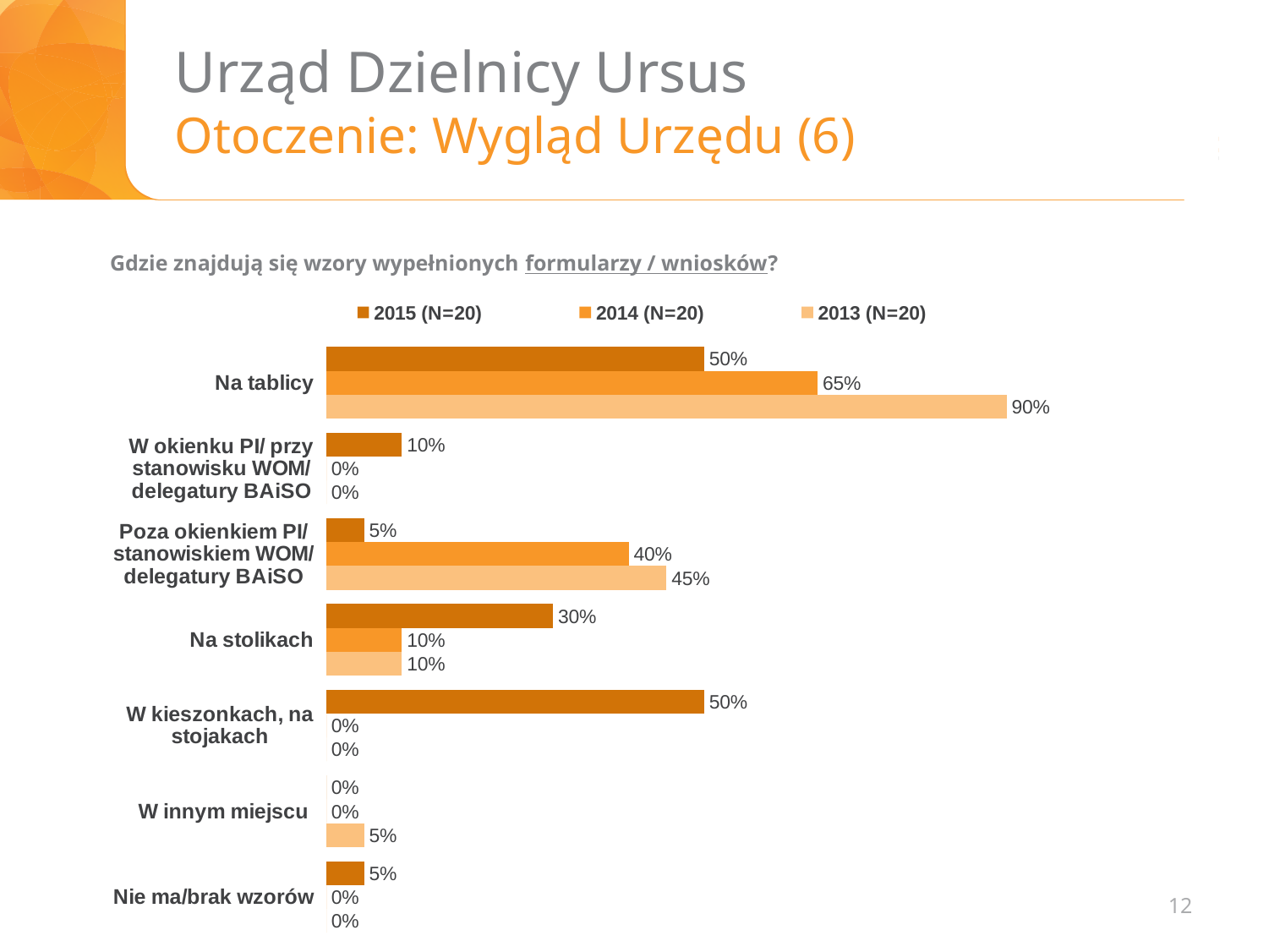
What is the value for 'W innym miejscu' in the 2013 (N=20) series? 5% What is the value for 'W kieszonkach, na stojakach' in the 2015 (N=20) series? 50% What is the value for 'Na stolikach' in the 2015 (N=20) series? 30% What kind of chart is shown on the slide? bar chart How many series does the legend list? 3 What question is the chart answering, as stated above it? Gdzie znajdują się wzory wypełnionych formularzy / wniosków? Which category has the highest value in the 2013 (N=20) series? Na tablicy What is the value for 'Poza okienkiem PI/ stanowiskiem WOM/ delegatury BAiSO' in the 2014 (N=20) series? 40% What is the difference between the 2013 (N=20) and 2015 (N=20) values for 'Na tablicy'? 40% What is the value for 'Na tablicy' in the 2013 (N=20) series? 90% Which is larger for 'Na stolikach': the 2015 (N=20) value or the 2014 (N=20) value? 2015 (N=20) How many categories are shown on the chart? 7